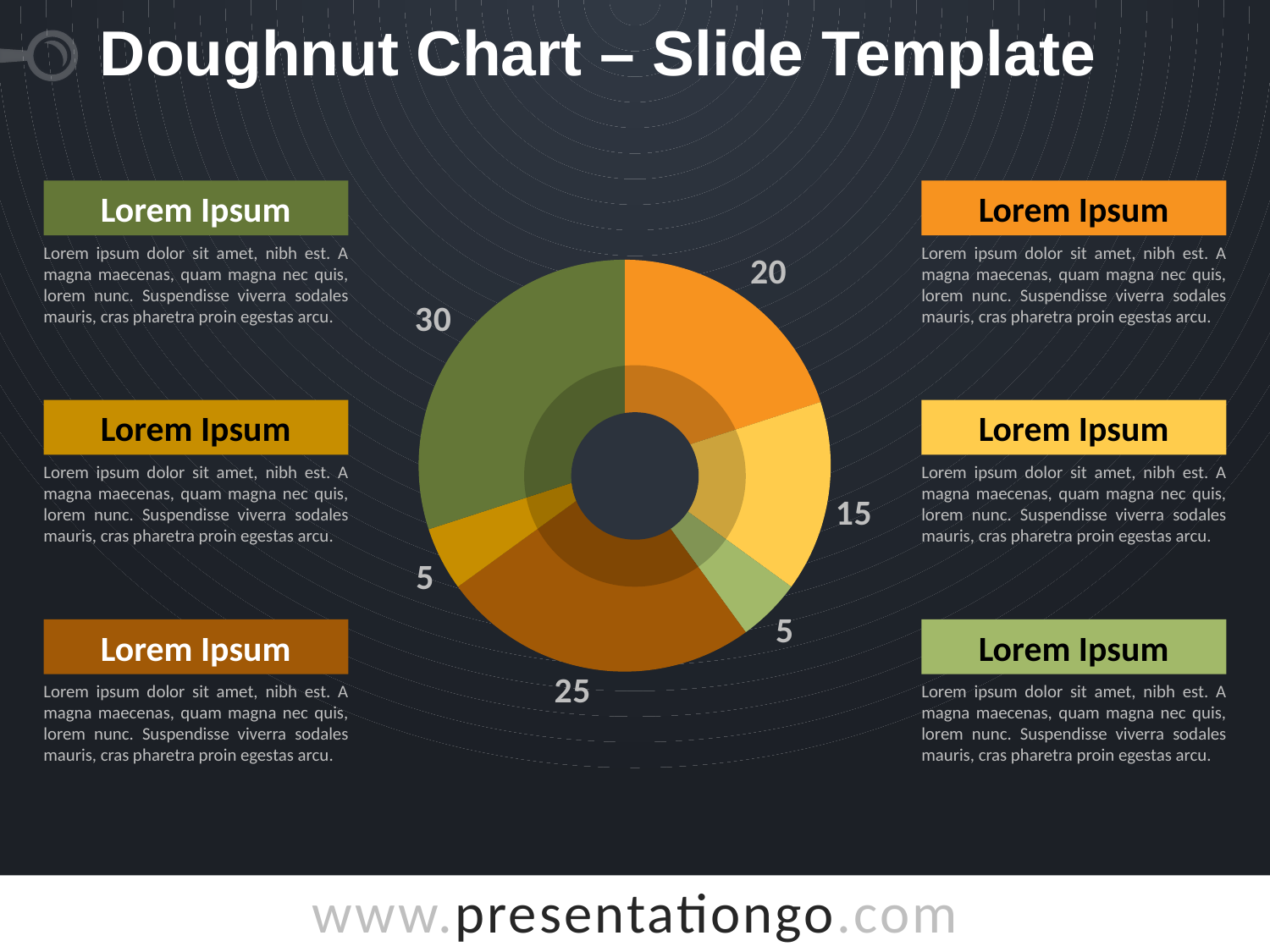
What kind of chart is shown on the slide? Doughnut chart What is the smallest value labelled on the outer ring? 5 What is the total of all the values labelled on the outer ring? 100 What is the value labelled on the olive green slice of the outer ring? 30 What is the value labelled on the yellow slice of the outer ring? 15 What is the title of the slide containing the chart? Doughnut Chart – Slide Template How many labelled slices does the outer ring have? 6 What is the value labelled on the orange slice of the outer ring? 20 Which is larger, the orange slice or the yellow slice of the outer ring? Orange slice What is the difference between the olive green slice (30) and the orange slice (20)? 10 What is the value labelled on the brown slice of the outer ring? 25 What is the largest value labelled on the outer ring? 30